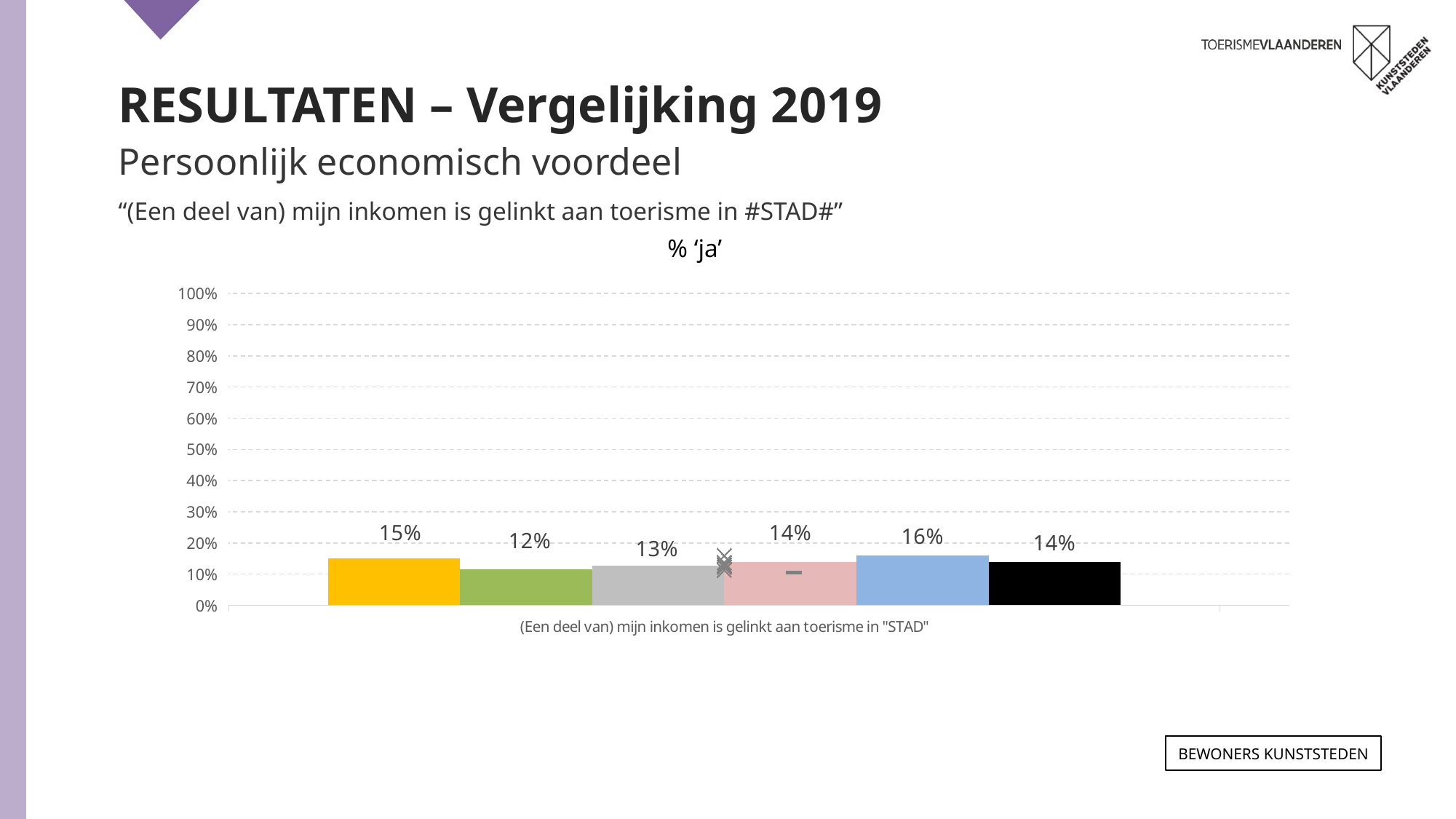
What is the value shown on the black (last) bar? 14% How many bars are plotted in the chart? 6 What is the value shown on the yellow (first) bar? 15% Which is larger, the value of the yellow bar or the value of the grey bar? The yellow bar (15%) Which bar has the highest value? The blue bar (16%) What is the value shown on the grey (third) bar? 13% What is the title of the chart? % 'ja' What is the value shown on the blue (fifth) bar? 16% Which bar has the lowest value? The green bar (12%) What type of chart is shown on the slide? Bar chart What is the difference between the highest bar (blue) and the lowest bar (green)? 4 percentage points What is the value shown on the green (second) bar? 12%